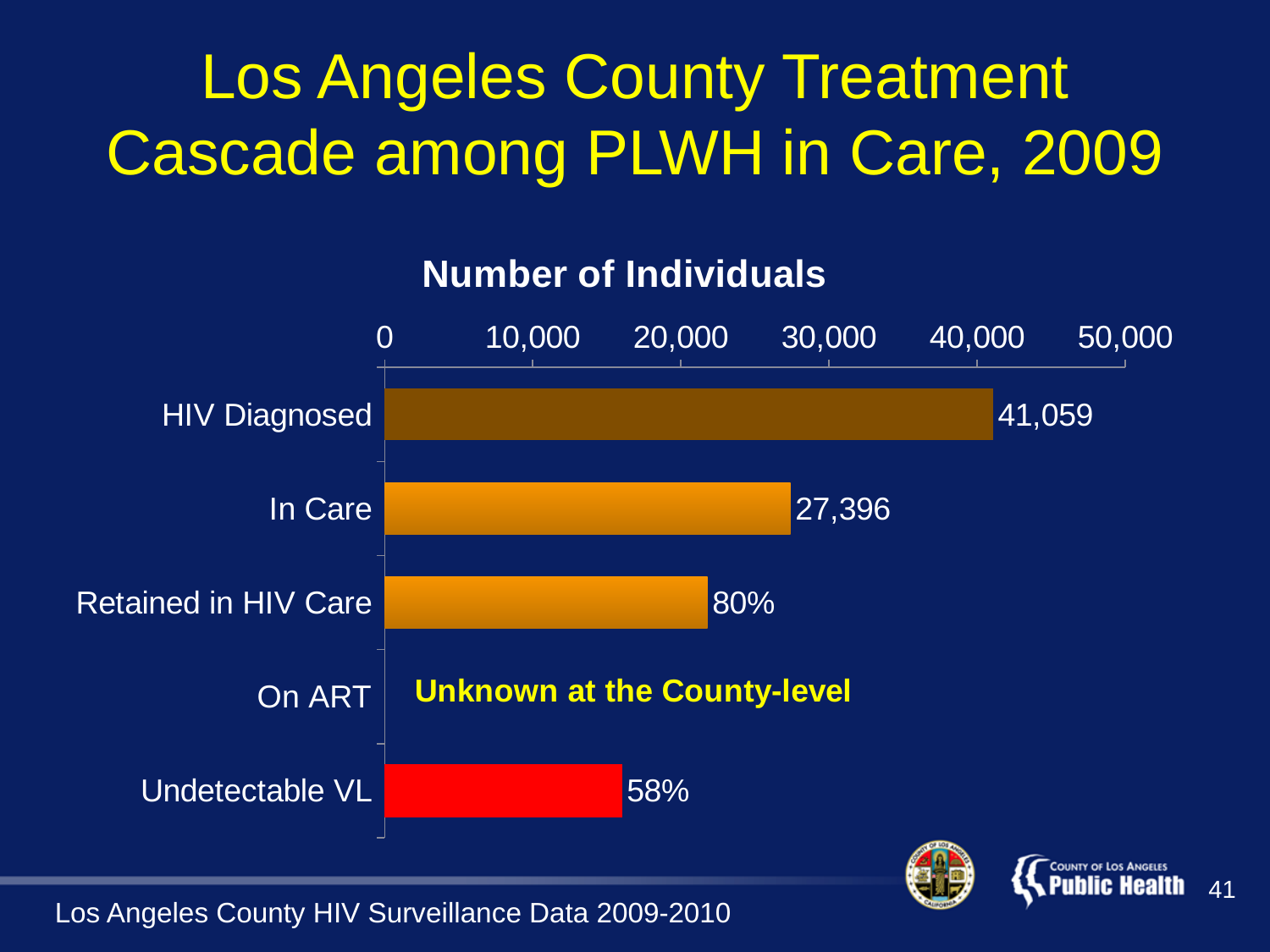
What is the data label shown for Undetectable VL? 58% Which is larger, the bar for In Care or the bar for Retained in HIV Care? In Care How many categories are listed on the vertical axis? 5 What text is shown in place of a bar for On ART? Unknown at the County-level Is the bar for Undetectable VL greater or less than 20,000 on the axis? less What is the data label for In Care? 27,396 What is the difference between the HIV Diagnosed value and the In Care value? 13,663 Which category has the shortest plotted bar? Undetectable VL What is the data label shown for Retained in HIV Care? 80% What kind of chart is shown on the slide? bar chart What is the data label for HIV Diagnosed? 41,059 Which category has the longest bar? HIV Diagnosed